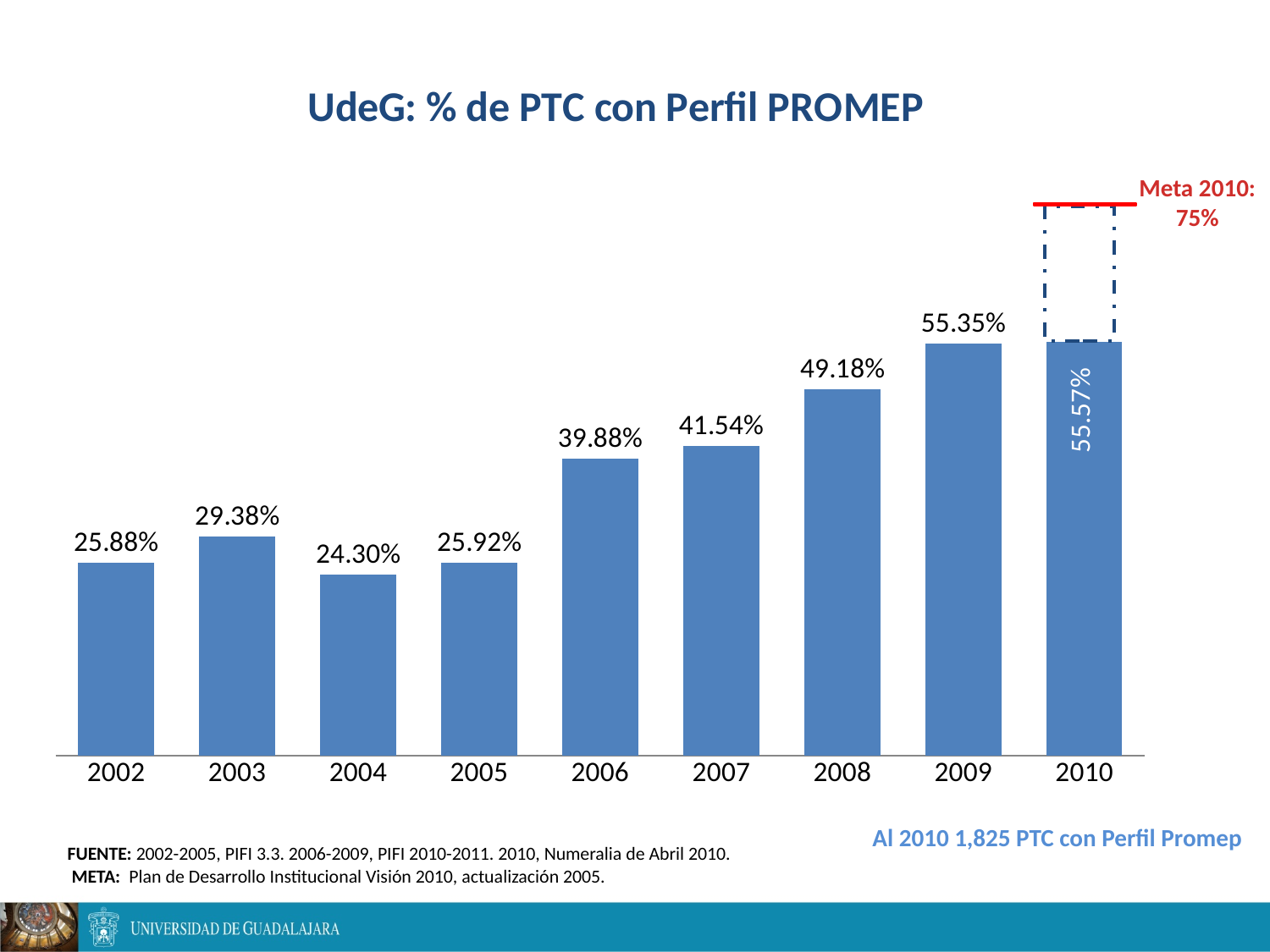
What is the Meta 2010 target shown on the chart? 75% Which year has the lowest value? 2004 What percentage of PTC had Perfil PROMEP in 2010? 55.57% What is the value for 2006? 39.88% How far below the Meta 2010 target of 75% is the 2010 value of 55.57%? 19.43 percentage points Which is larger, the value for 2003 or the value for 2005? 2003 Do the values generally rise or fall from 2005 to 2010? Rise What kind of chart is shown on the slide? Bar chart What is the value shown for 2002? 25.88% Which year has the highest value? 2010 How many years are shown on the x axis? 9 What is the difference between the 2009 value and the 2008 value? 6.17 percentage points